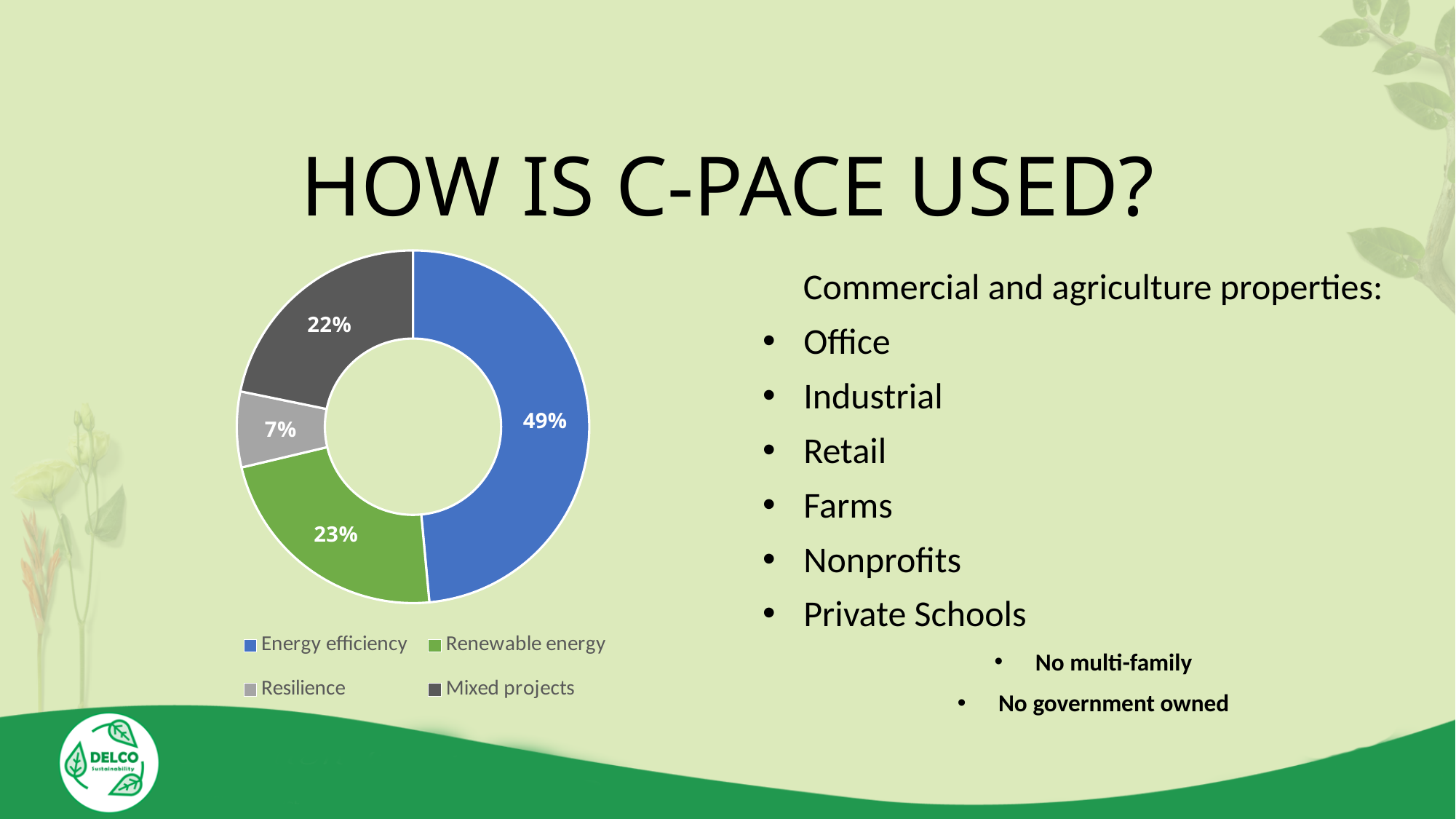
What share of the doughnut chart is Resilience? 7% How many categories does the doughnut chart show? 4 What kind of chart is shown on the slide? Doughnut chart Which category has the smallest share of the doughnut chart? Resilience What share of the doughnut chart is Mixed projects? 22% What is the difference in percentage points between Renewable energy and Resilience? 16 What is the difference in percentage points between Energy efficiency and Mixed projects? 27 Which category has the largest share of the doughnut chart? Energy efficiency What share of the doughnut chart is Renewable energy? 23% What share of the doughnut chart is Energy efficiency? 49% What colour is the Mixed projects slice in the chart? Dark grey Which is larger, the share for Energy efficiency or the share for Renewable energy? Energy efficiency